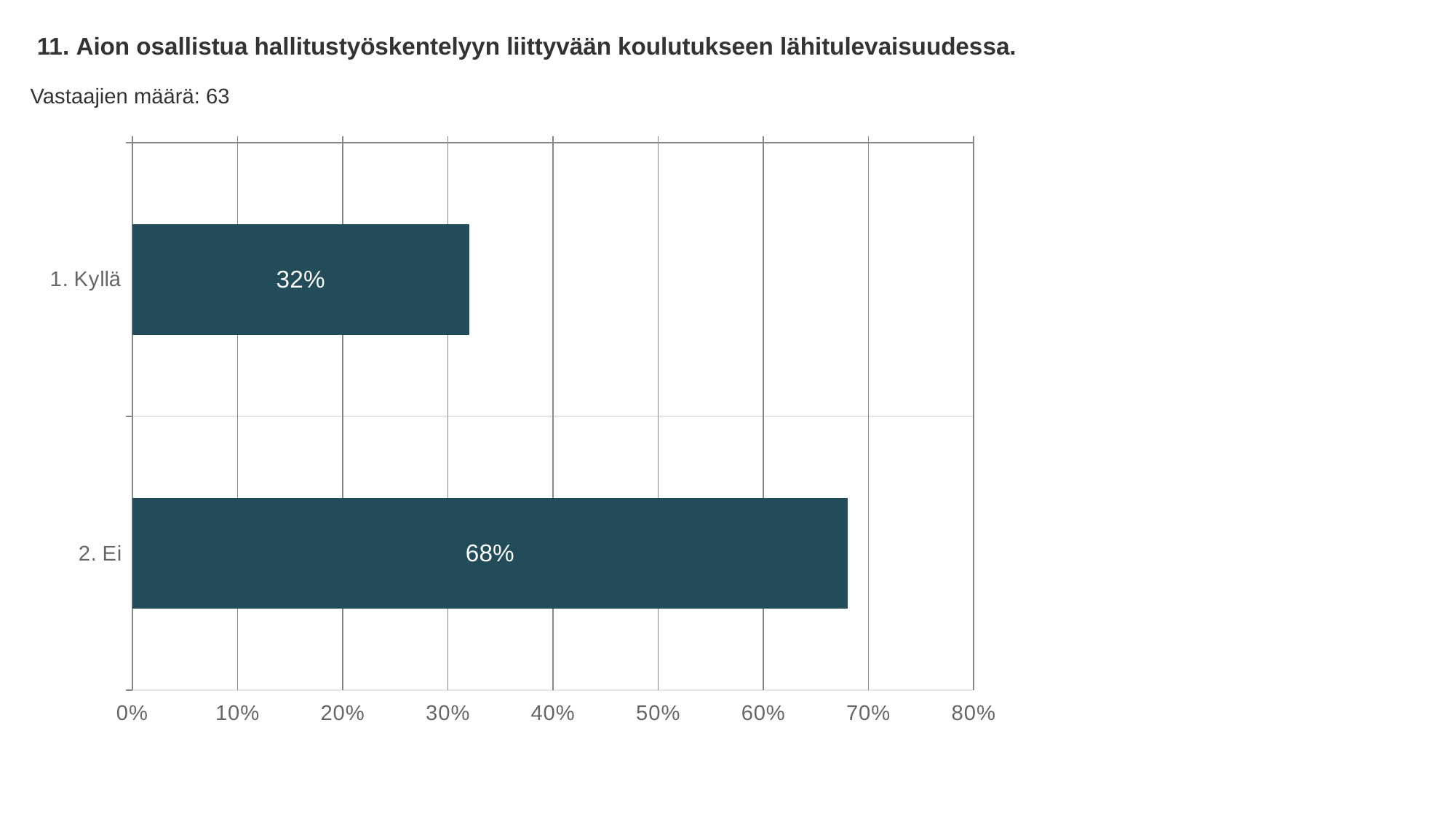
Which category has the highest value? 2. Ei What is the number of respondents (Vastaajien määrä) stated on the slide? 63 Is the value for "1. Kyllä" greater or less than 40%? less Which category has the lowest value? 1. Kyllä What is the value for "1. Kyllä"? 32% What kind of chart is shown on the slide? Bar chart Which is larger, the value for "1. Kyllä" or the value for "2. Ei"? 2. Ei How many categories are shown in the chart? 2 Is the value for "2. Ei" greater or less than 60%? greater What is the difference between the values for "2. Ei" and "1. Kyllä"? 36% What is the value for "2. Ei"? 68% What is the highest value shown on the x axis? 80%